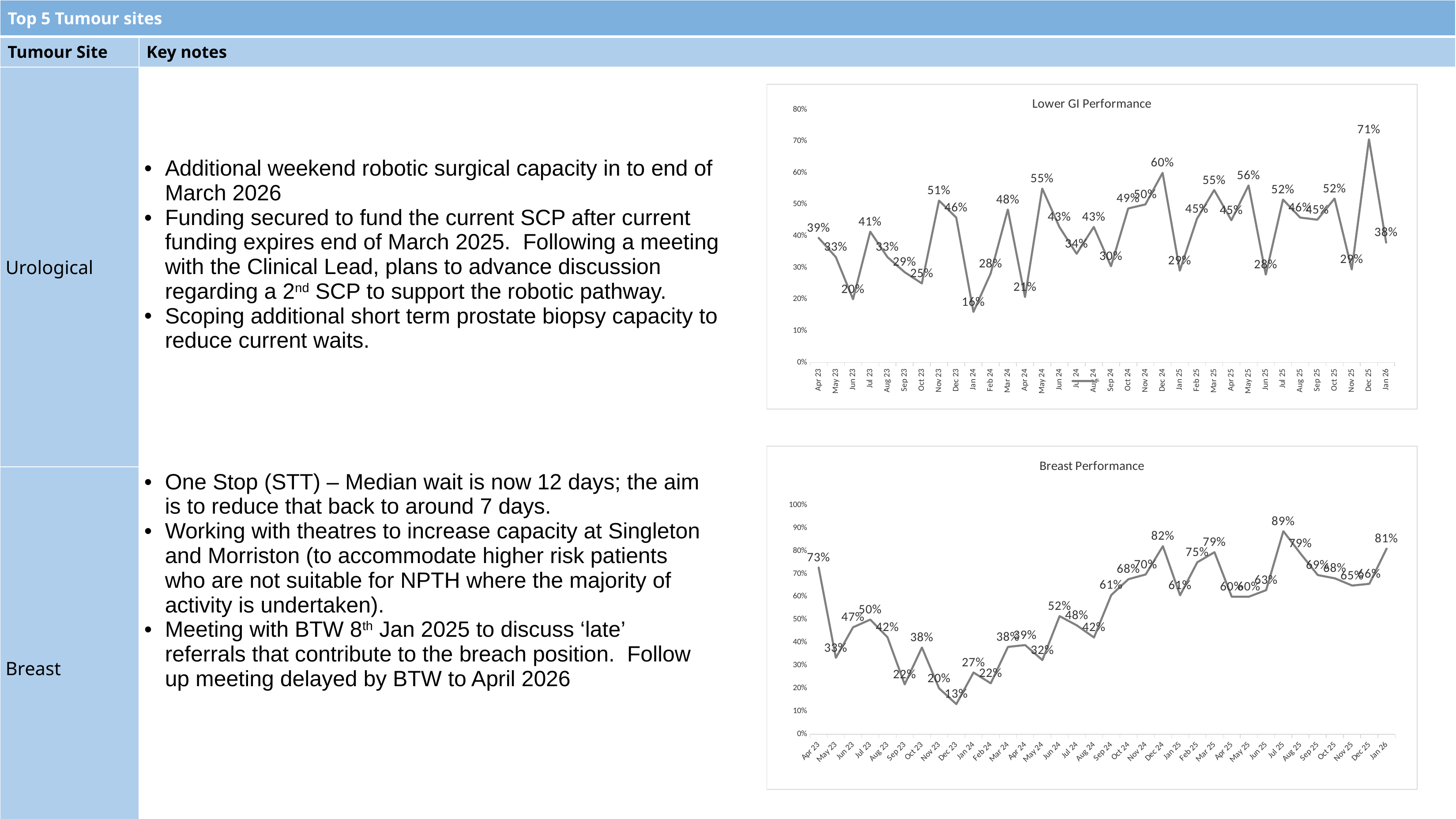
What is the title of the lower chart on the slide? Breast Performance In the Breast Performance chart, which month has the highest value? Jul 25 In the Lower GI Performance chart, which month has the lowest value? Jan 24 In the Lower GI Performance chart, what is the difference between the Dec 25 value and the Jan 26 value? 33 percentage points In the Breast Performance chart, what is the value for Apr 23? 73% In the Lower GI Performance chart, what is the value for Dec 25? 71% In the Breast Performance chart, what is the difference between the Jul 25 value and the Dec 23 value? 76 percentage points In the Breast Performance chart, which month has the lowest value? Dec 23 In the Lower GI Performance chart, what is the value for Jan 26? 38% In the Lower GI Performance chart, which month has the highest value? Dec 25 What kind of chart is the Lower GI Performance chart? Line chart In the Breast Performance chart, which is larger, the value for Dec 24 or the value for Jan 25? Dec 24